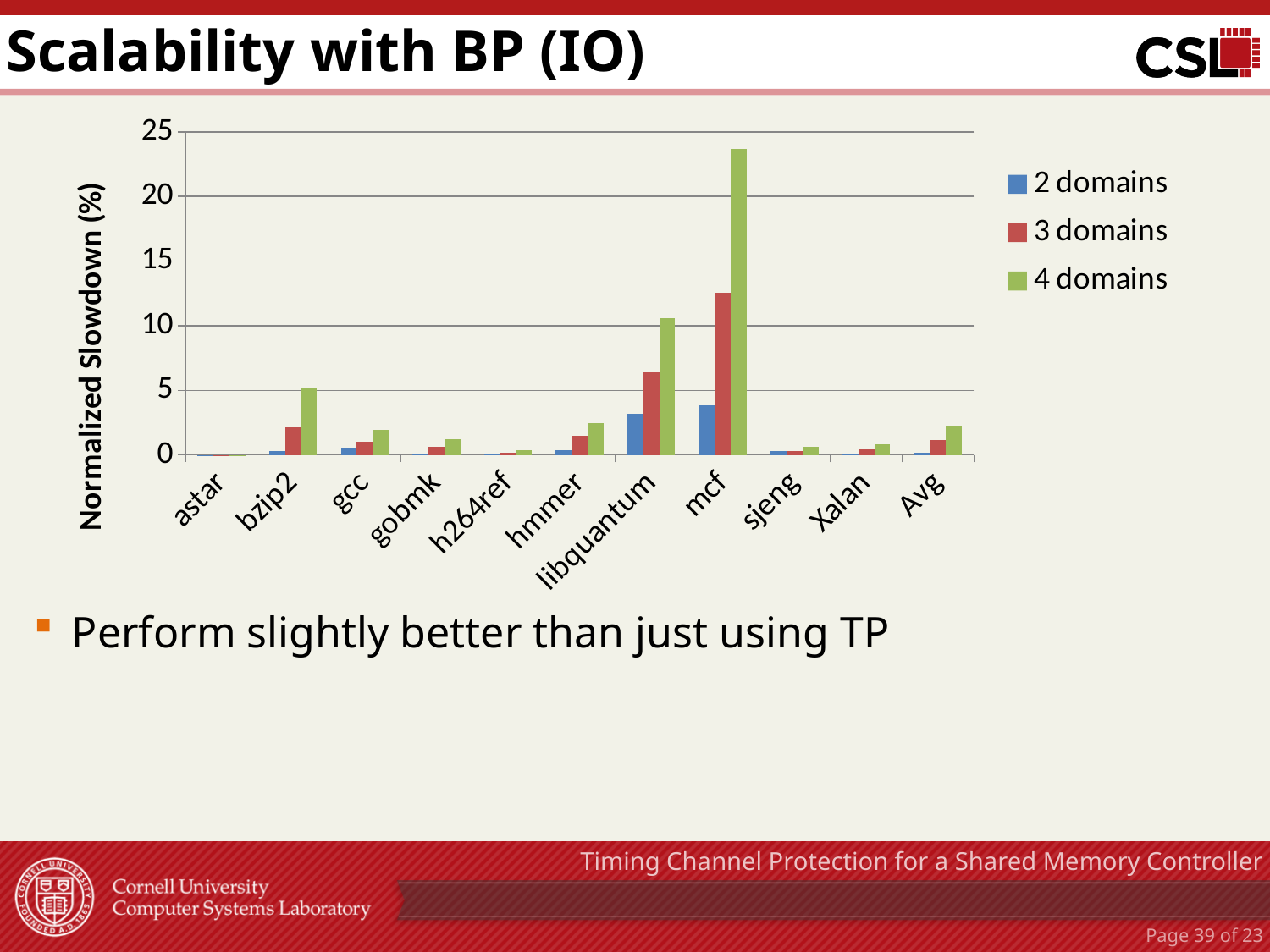
Which category has the highest normalized slowdown for 4 domains? mcf For mcf, do the values rise or fall as the number of domains increases from 2 to 4? rise Is the 3 domains value for mcf greater or less than 10? greater Is the 4 domains value for Avg greater or less than 5? less How many benchmark categories are shown on the x axis? 11 What is the label of the y axis? Normalized Slowdown (%) Is the 2 domains value for mcf greater or less than 5? less For 4 domains, which is larger: mcf or libquantum? mcf What kind of chart is shown on the slide? bar chart How many series does the legend list? 3